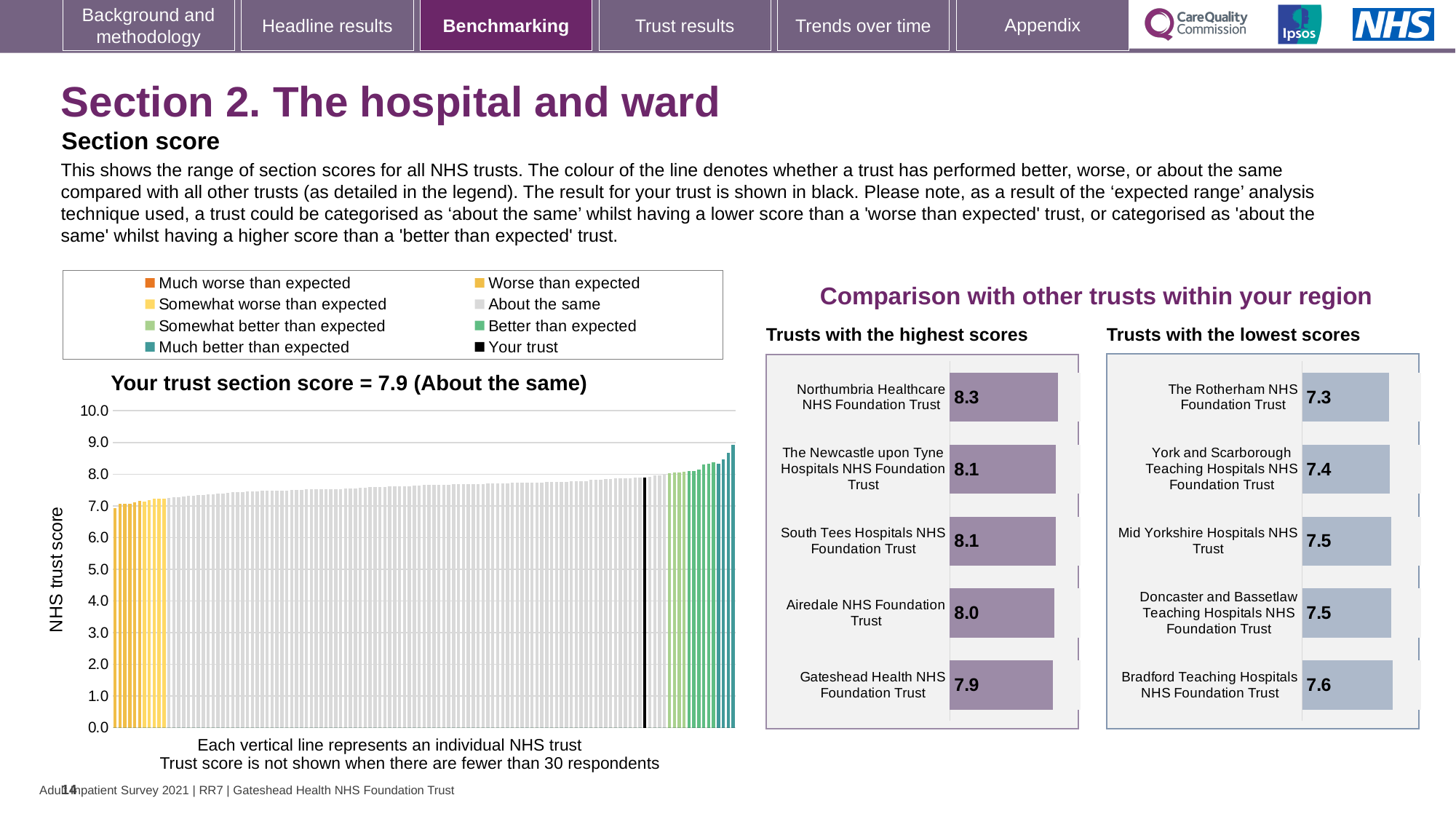
In the 'Trusts with the lowest scores' chart, which trust has the highest score? Bradford Teaching Hospitals NHS Foundation Trust In the 'Trusts with the highest scores' chart, what is the difference between the scores of Northumbria Healthcare NHS Foundation Trust and Gateshead Health NHS Foundation Trust? 0.4 In the 'Trusts with the lowest scores' chart, how many trusts are listed? 5 In the 'Trusts with the highest scores' chart, what is the score for Northumbria Healthcare NHS Foundation Trust? 8.3 In the 'Your trust section score' chart, do the values rise or fall from left to right along the x axis? rise In the 'Your trust section score' chart, is the value of the tallest bar greater or less than 8.0? greater In the 'Trusts with the highest scores' chart, what is the score for Airedale NHS Foundation Trust? 8.0 How many entries does the legend above the 'Your trust section score' chart list? 8 In the 'Trusts with the lowest scores' chart, what is the score for The Rotherham NHS Foundation Trust? 7.3 In the 'Trusts with the highest scores' chart, which trust has the lowest score? Gateshead Health NHS Foundation Trust In the 'Trusts with the lowest scores' chart, which has the larger score: The Rotherham NHS Foundation Trust or York and Scarborough Teaching Hospitals NHS Foundation Trust? York and Scarborough Teaching Hospitals NHS Foundation Trust In the 'Your trust section score' chart, what is the section score for your trust? 7.9